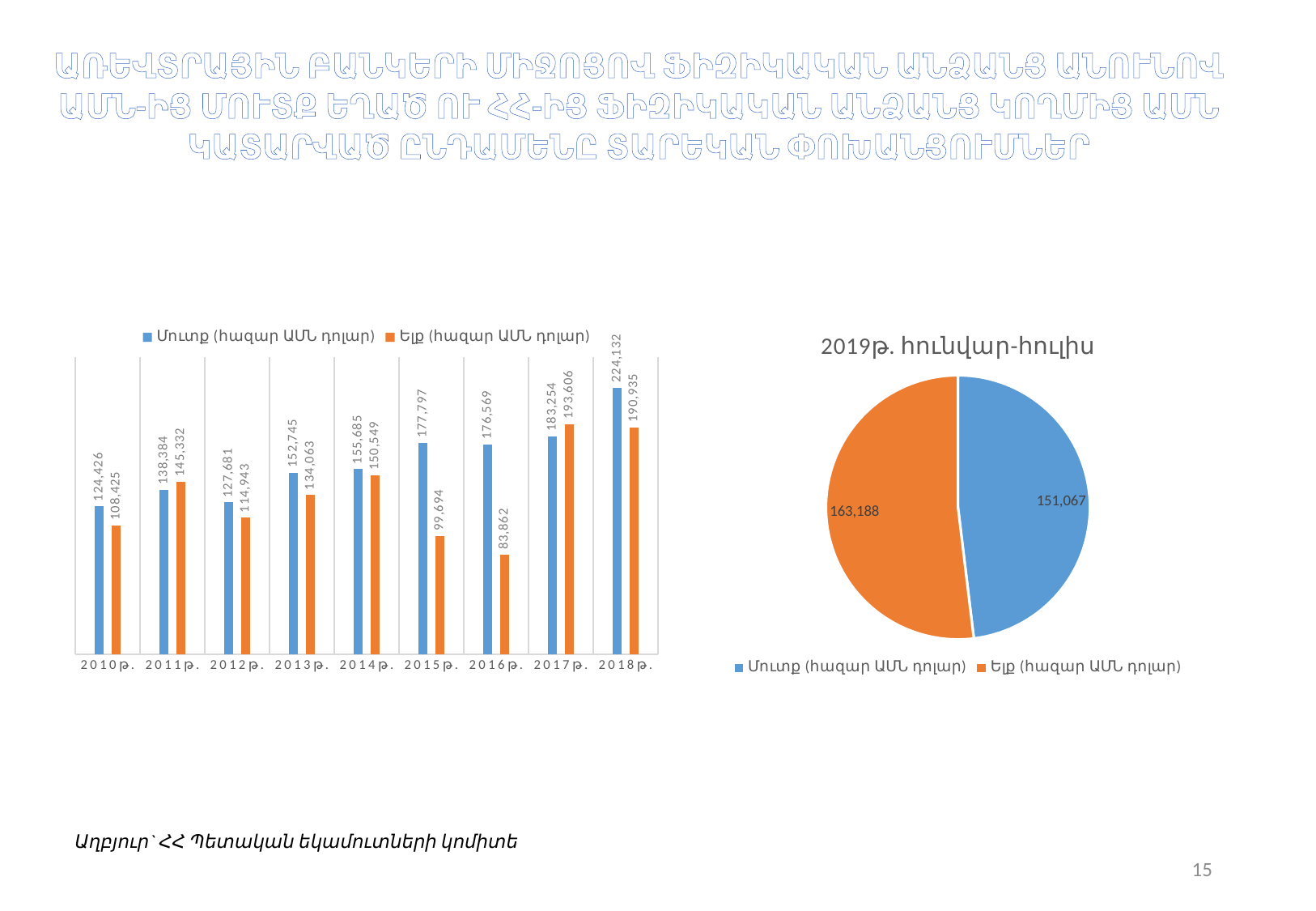
In the pie chart titled 2019թ. հունվար-հուլիս, what is the difference between the Ելք and Մուտք slices? 12,121 How many years are shown on the left bar chart? 9 What type of chart is the chart on the left of the slide? Bar chart On the left bar chart, which is larger in 2017թ., Մուտք or Ելք? Ելք In the pie chart titled 2019թ. հունվար-հուլիս, which slice is larger, Մուտք or Ելք? Ելք How many series does the legend of the left bar chart list? 2 On the left bar chart, what is the value of Ելք (հազար ԱՄՆ դոլար) for 2015թ.? 99,694 On the left bar chart, which year has the highest Մուտք (հազար ԱՄՆ դոլար) value? 2018թ. On the left bar chart, which year has the lowest Ելք (հազար ԱՄՆ դոլար) value? 2016թ. In the pie chart titled 2019թ. հունվար-հուլիս, what is the value of the Ելք (հազար ԱՄՆ դոլար) slice? 163,188 On the left bar chart, what is the difference between Մուտք and Ելք in 2016թ.? 92,707 On the left bar chart, what is the value of Մուտք (հազար ԱՄՆ դոլար) for 2018թ.? 224,132